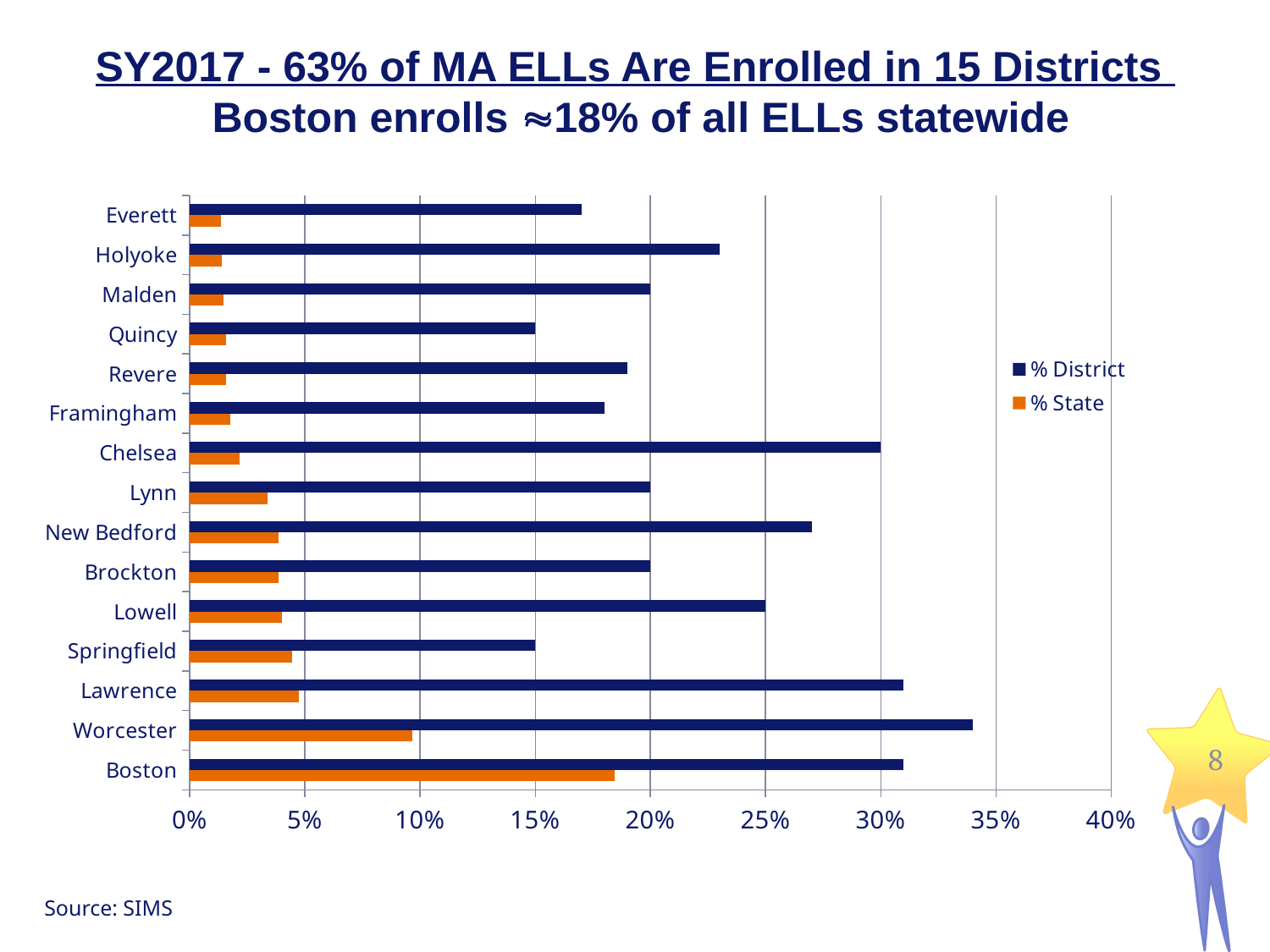
How many series does the legend list? 2 How many districts are listed on the chart? 15 Which has the larger % District value, New Bedford or Lowell? New Bedford Is the % District value for Holyoke greater or less than 20%? greater What is the % District value for Lowell? 25% Which district has the highest % District value? Worcester Which district has the highest % State value? Boston What is the % District value for Chelsea? 30% What are the two entries in the chart's legend? % District and % State What kind of chart is shown on the slide? bar chart Is the % State value for Boston greater or less than 15%? greater